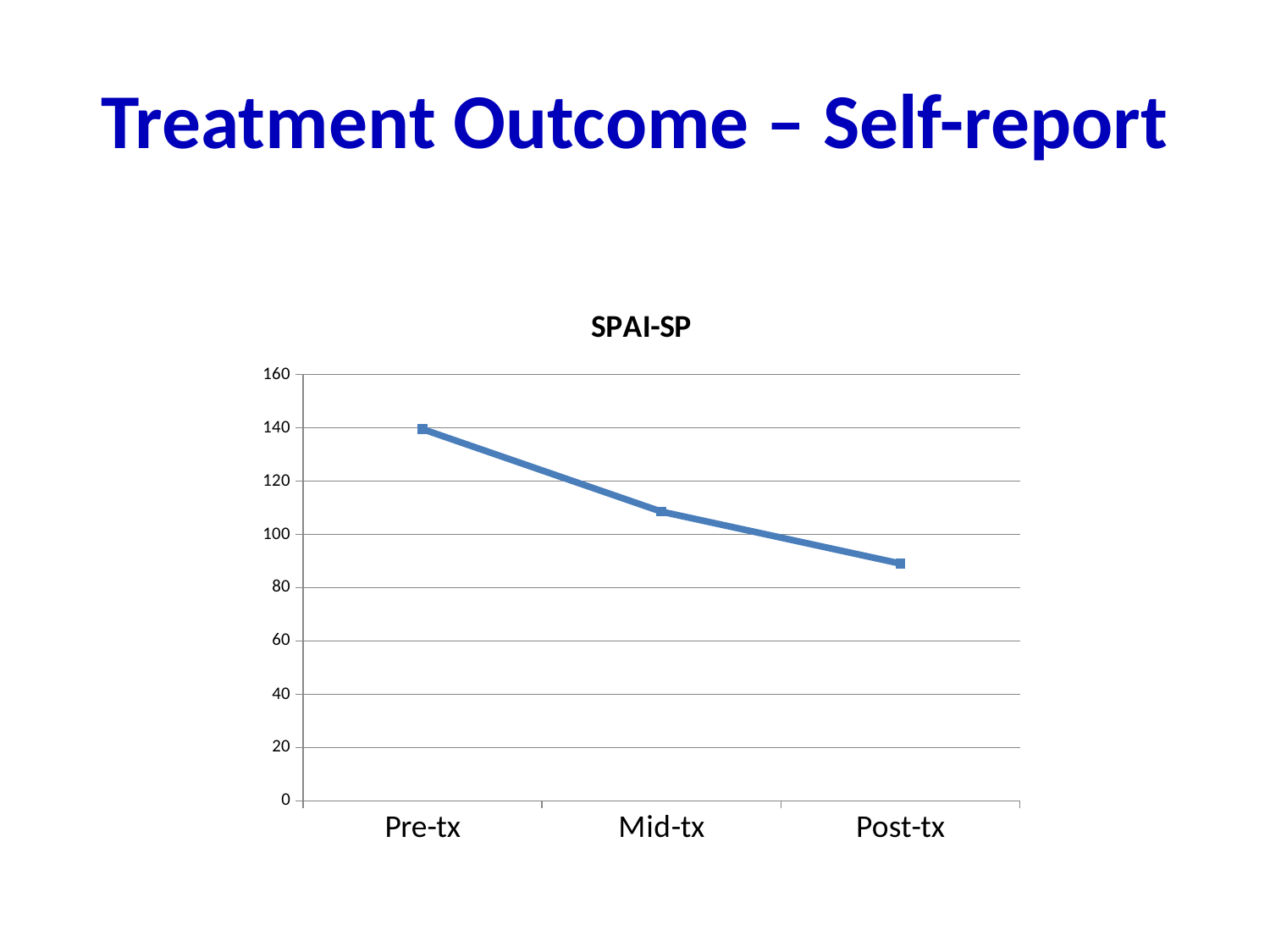
What kind of chart is shown on the slide? line chart Which is larger, the value at Pre-tx or the value at Mid-tx? Pre-tx Which time point has the lowest SPAI-SP value? Post-tx Is the value for Mid-tx greater or less than 100? greater Do the SPAI-SP values rise or fall from Pre-tx to Post-tx? fall Which time point has the highest SPAI-SP value? Pre-tx How many time points are plotted on the x axis? 3 Is the value for Post-tx greater or less than 100? less What is the title of the chart? SPAI-SP What is the highest value shown on the y axis? 160 Is the value for Pre-tx greater or less than 120? greater Which is larger, the value at Mid-tx or the value at Post-tx? Mid-tx